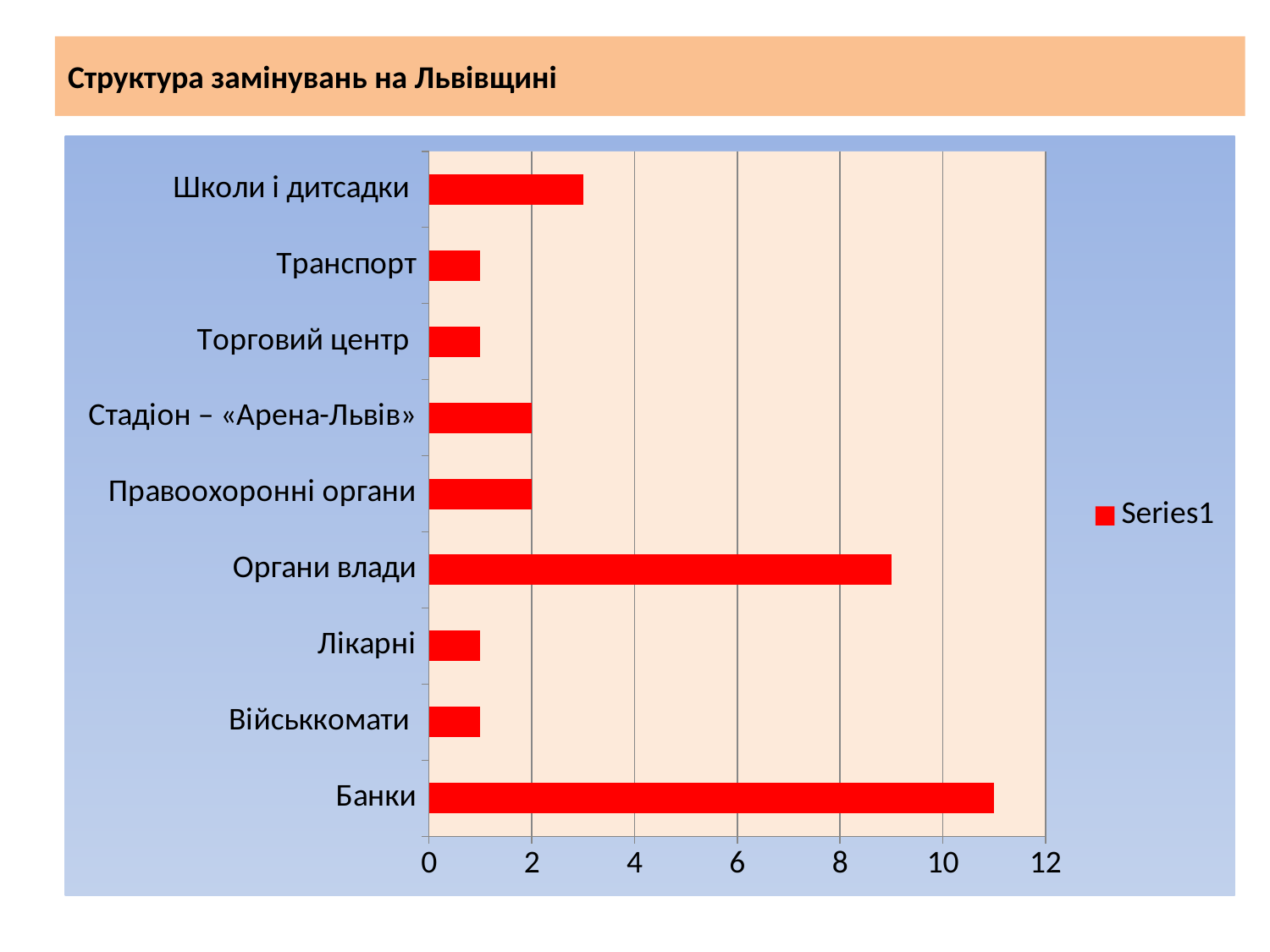
Is the value for Транспорт greater or less than 2? less Which category has the highest value? Банки What kind of chart is shown on the slide? bar chart What is the value for Правоохоронні органи? 2 Is the value for Органи влади greater or less than 8? greater Is the value for Банки greater or less than 10? greater What is the title of the slide above the chart? Структура замінувань на Львівщині How many categories are plotted in the chart? 9 How many series does the legend list? 1 Which is larger, the value for Органи влади or the value for Школи і дитсадки? Органи влади What is the value for Стадіон – «Арена-Львів»? 2